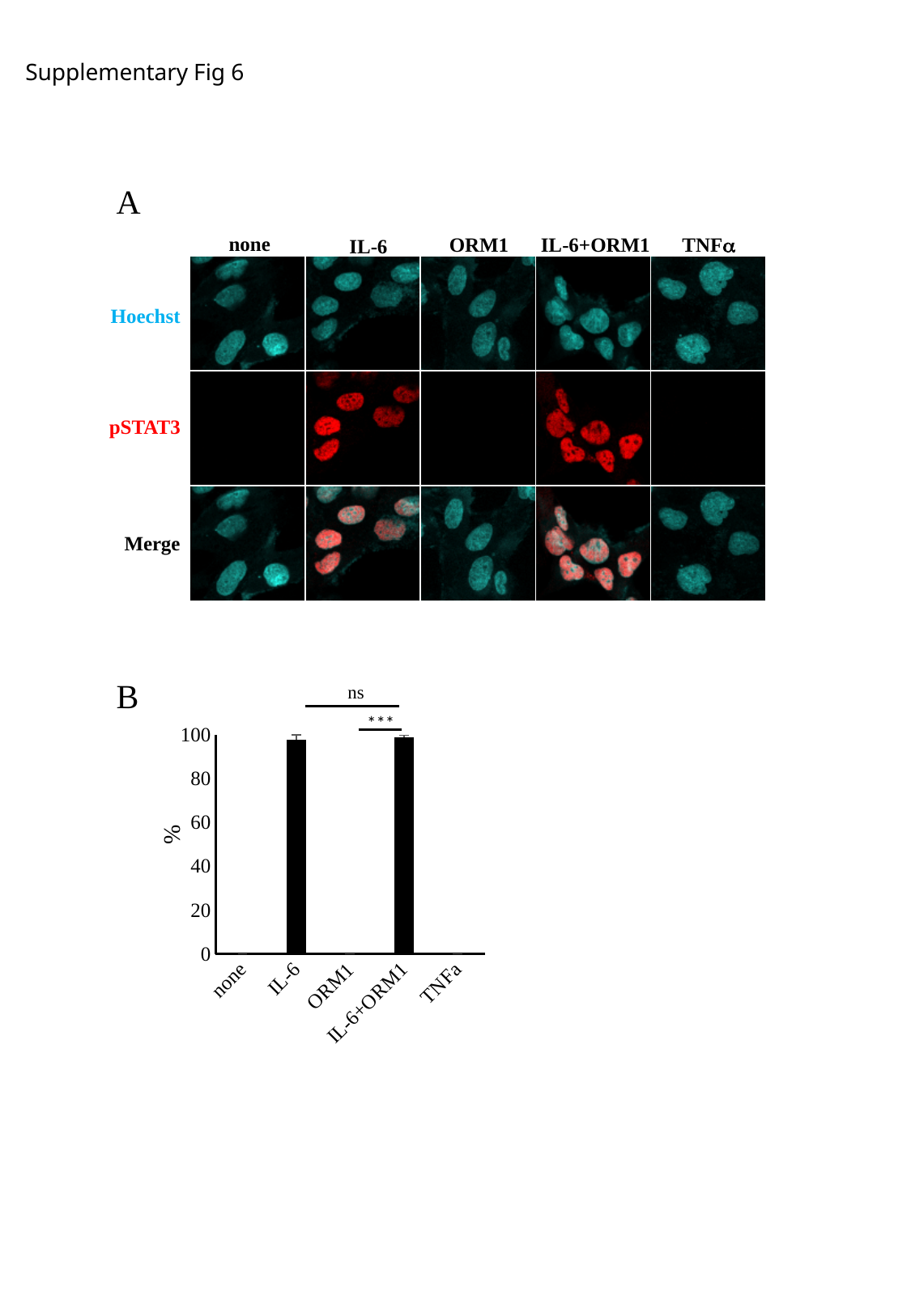
In panel B, is the value for TNFa greater or less than 20? less In panel B, is the value for none greater or less than 20? less In panel B, is the value for IL-6 greater or less than 80? greater In panel B, which is larger, the value for IL-6 or the value for ORM1? IL-6 In panel B, how many categories are shown on the x axis? 5 In panel B, what significance annotation is shown between the IL-6 and IL-6+ORM1 bars? ns In panel B, which is larger, the value for IL-6+ORM1 or the value for TNFa? IL-6+ORM1 In panel B, what kind of chart is shown? bar chart In panel B, what is the label on the y axis? %